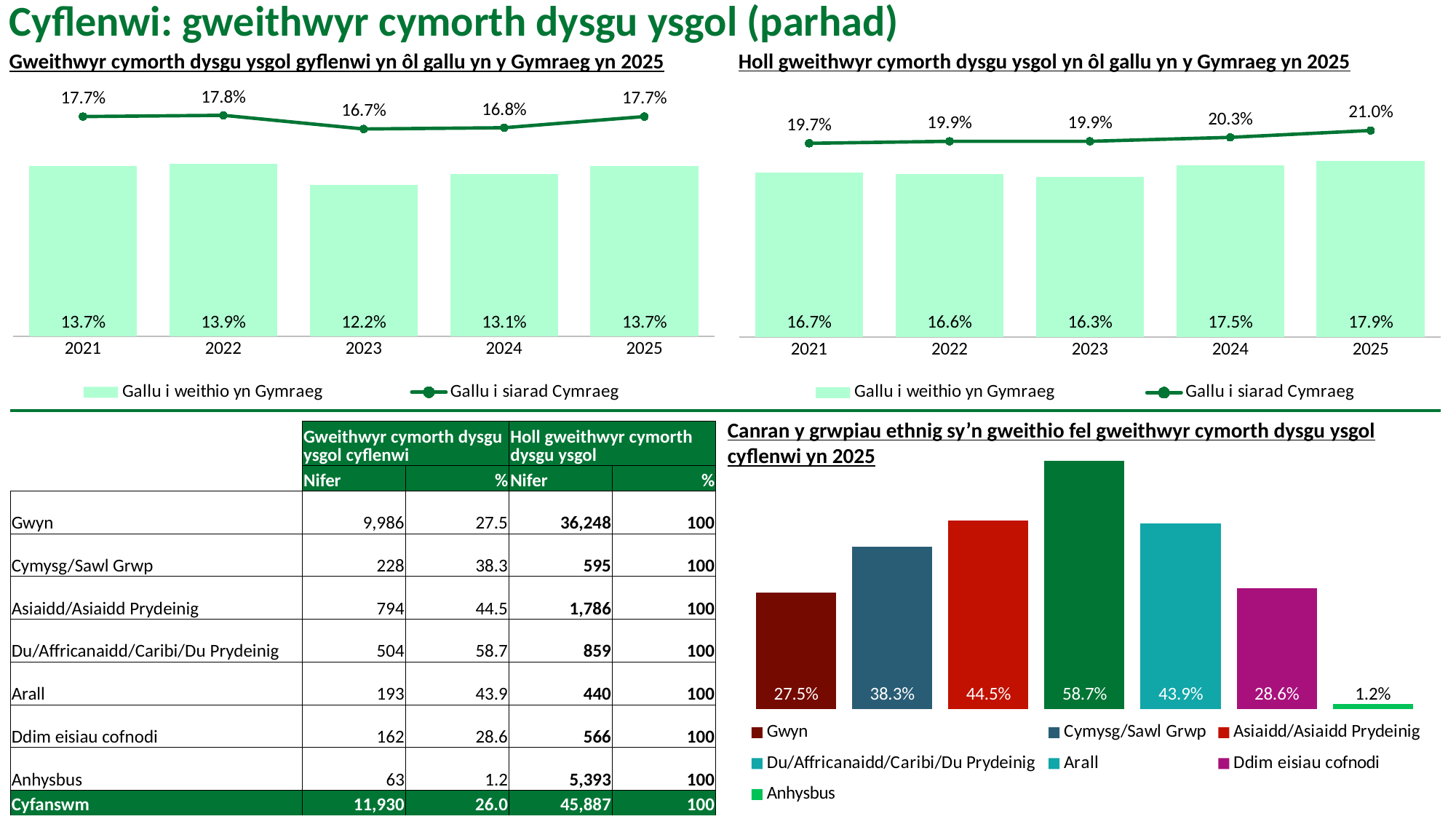
In the chart titled 'Canran y grwpiau ethnig sy'n gweithio fel gweithwyr cymorth dysgu ysgol cyflenwi yn 2025', which group has the lowest value? Anhysbus In the chart titled 'Gweithwyr cymorth dysgu ysgol gyflenwi yn ôl gallu yn y Gymraeg yn 2025', what is the value for 'Gallu i siarad Cymraeg' in 2022? 17.8% In the chart titled 'Gweithwyr cymorth dysgu ysgol gyflenwi yn ôl gallu yn y Gymraeg yn 2025', what is the value for 'Gallu i weithio yn Gymraeg' in 2023? 12.2% In the chart titled 'Holl gweithwyr cymorth dysgu ysgol yn ôl gallu yn y Gymraeg yn 2025', does the 'Gallu i siarad Cymraeg' series rise or fall from 2023 to 2025? rise In the chart titled 'Holl gweithwyr cymorth dysgu ysgol yn ôl gallu yn y Gymraeg yn 2025', how many series does the legend list? 2 In the chart titled 'Canran y grwpiau ethnig sy'n gweithio fel gweithwyr cymorth dysgu ysgol cyflenwi yn 2025', which is larger: the value for 'Asiaidd/Asiaidd Prydeinig' or the value for 'Arall'? Asiaidd/Asiaidd Prydeinig In the chart titled 'Gweithwyr cymorth dysgu ysgol gyflenwi yn ôl gallu yn y Gymraeg yn 2025', what is the difference between the 'Gallu i siarad Cymraeg' and 'Gallu i weithio yn Gymraeg' values in 2025? 4.0% What kind of chart is the chart titled 'Canran y grwpiau ethnig sy'n gweithio fel gweithwyr cymorth dysgu ysgol cyflenwi yn 2025'? bar chart In the chart titled 'Gweithwyr cymorth dysgu ysgol gyflenwi yn ôl gallu yn y Gymraeg yn 2025', which year has the lowest value for 'Gallu i weithio yn Gymraeg'? 2023 In the chart titled 'Canran y grwpiau ethnig sy'n gweithio fel gweithwyr cymorth dysgu ysgol cyflenwi yn 2025', what is the value for 'Du/Affricanaidd/Caribi/Du Prydeinig'? 58.7% In the chart titled 'Holl gweithwyr cymorth dysgu ysgol yn ôl gallu yn y Gymraeg yn 2025', what is the value for 'Gallu i siarad Cymraeg' in 2025? 21.0% In the chart titled 'Holl gweithwyr cymorth dysgu ysgol yn ôl gallu yn y Gymraeg yn 2025', which year has the highest value for 'Gallu i weithio yn Gymraeg'? 2025